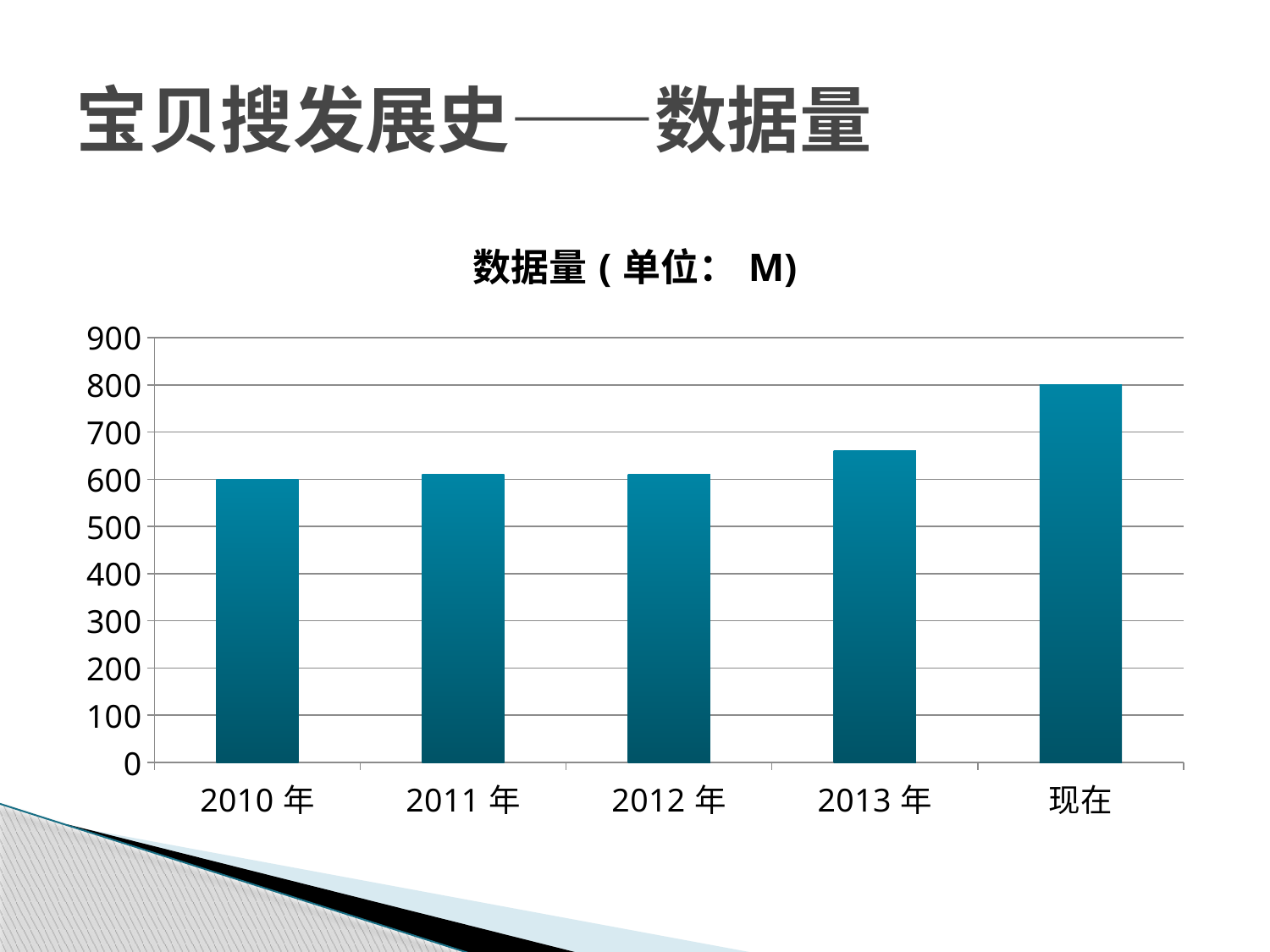
Which is larger, the value for 2013 年 or the value for 现在? 现在 What is the value for 现在 in the chart? 800 What is the value for 2010 年 in the chart? 600 What is the title of the chart? 数据量（单位： M) What kind of chart is shown on the slide? bar chart Is the value for 2013 年 greater or less than 700? less Is the value for 2013 年 greater or less than 600? greater Is the value for 2011 年 greater or less than 500? greater Which category has the highest value in the chart? 现在 Do the values generally rise or fall from 2010 年 to 现在? rise How many categories are shown on the x axis of the chart? 5 What is the difference between the value for 现在 and the value for 2010 年? 200